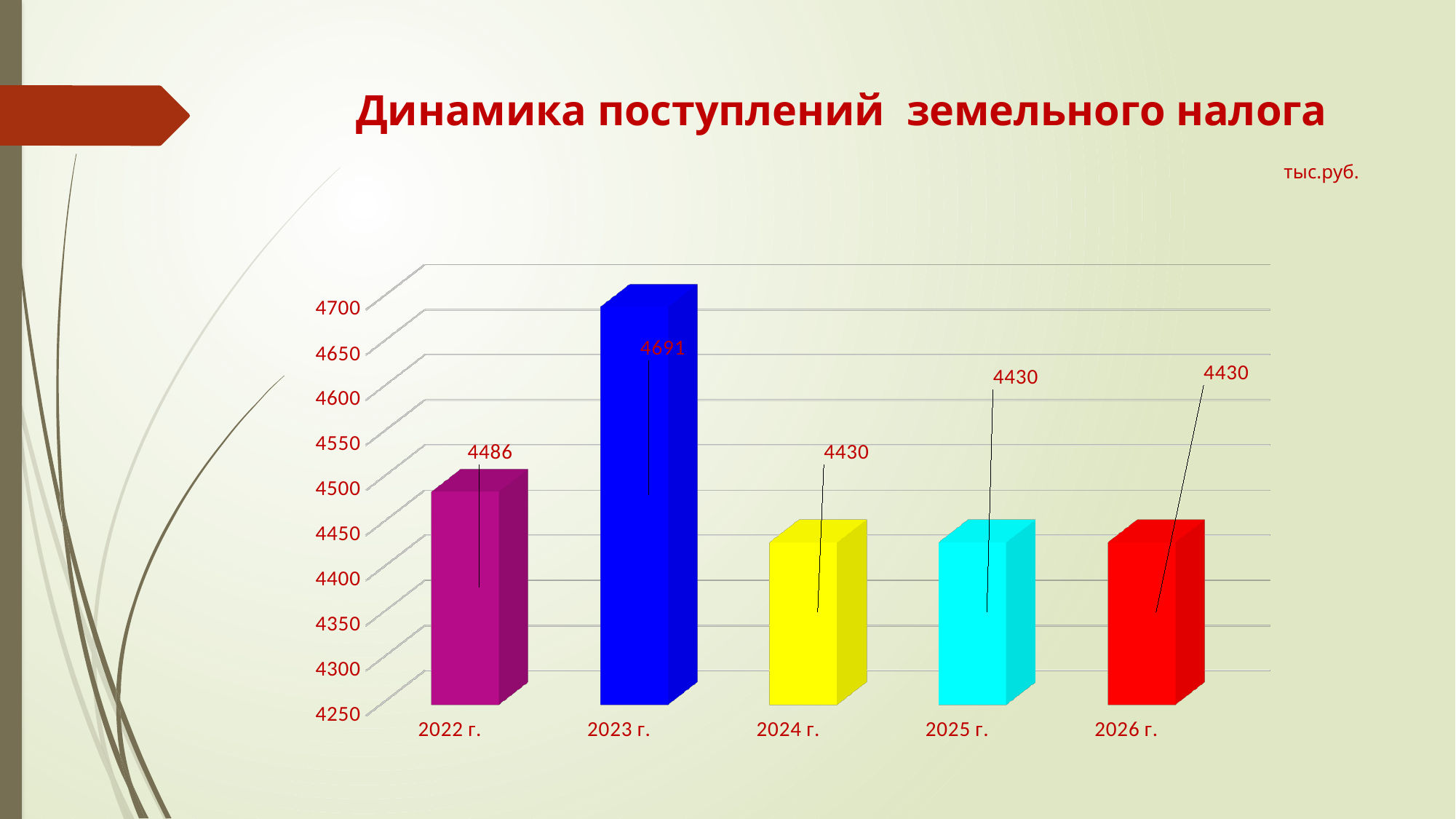
Is the value for 2023 г. greater or less than 4650? greater What kind of chart is shown on the slide? bar chart Which year has the highest value? 2023 г. What is the difference between the values for 2022 г. and 2024 г.? 56 How many years are shown on the x axis? 5 What is the title of the chart? Динамика поступлений земельного налога What is the value for 2024 г.? 4430 What is the value for 2022 г.? 4486 What is the value for 2026 г.? 4430 Which is larger, the value for 2022 г. or the value for 2025 г.? 2022 г. What is the difference between the values for 2023 г. and 2022 г.? 205 What is the value for 2023 г.? 4691